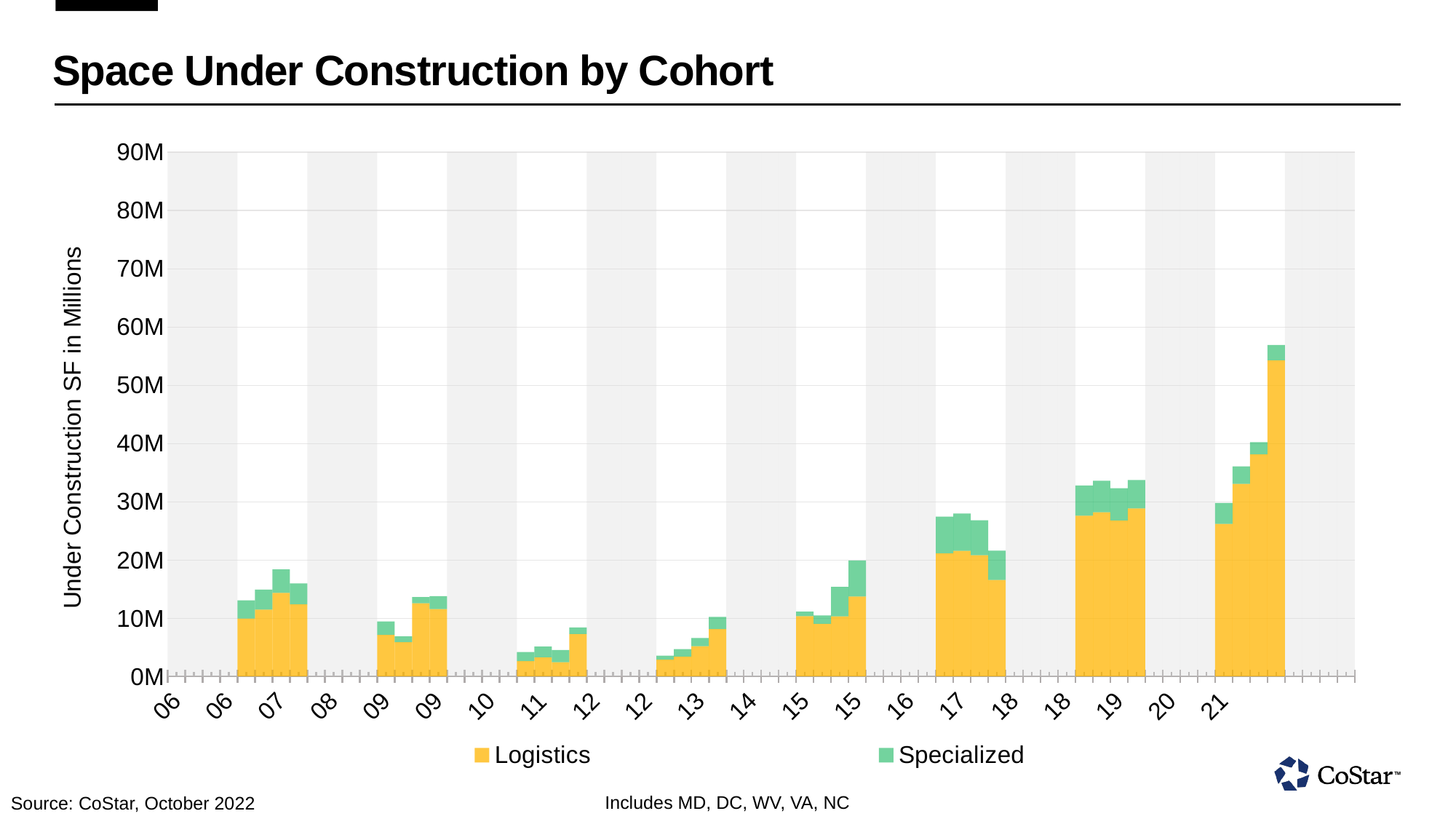
What kind of chart is shown on the slide? Stacked bar chart Are the totals of the bars in the cluster around the 19 label greater or less than 30M? greater Which cluster of bars contains the tallest bar on the chart? 21 How many series does the legend list? 2 What is the title of the chart? Space Under Construction by Cohort What are the two series named in the legend? Logistics and Specialized Which cluster has taller bars overall, the one around the 19 label or the one around the 17 label? 19 Is the total of the tallest bar (the rightmost bar) greater or less than 50M? greater Do the bar totals generally rise or fall from left to right across the chart? rise In the rightmost bar, which series is larger, Logistics or Specialized? Logistics Are the totals of the bars in the cluster around the 17 label greater or less than 30M? less